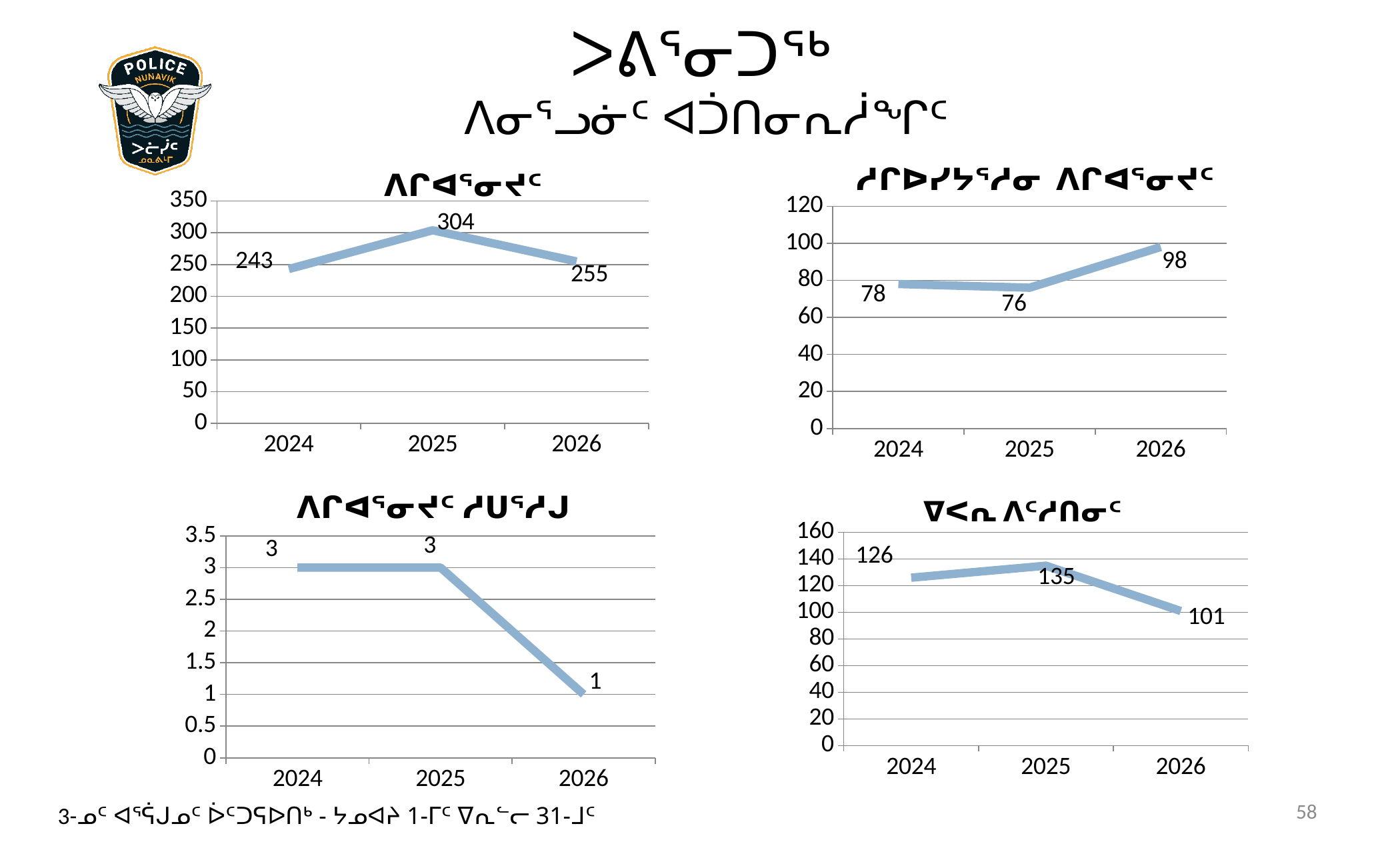
In the top-left chart, what is the difference between the 2025 and 2024 values? 61 What type of chart is the bottom-right chart? Line chart In the top-left chart, which year has the lowest value? 2024 In the top-right chart, is the value for 2024 larger or smaller than the value for 2025? larger In the top-left chart, what is the value for 2025? 304 In the bottom-left chart, what is the value for 2026? 1 In the bottom-right chart, what is the value for 2024? 126 In the top-right chart, what is the value for 2026? 98 In the bottom-left chart, how many data points are plotted? 3 In the bottom-right chart, what is the difference between the 2025 and 2026 values? 34 In the top-right chart, which year has the highest value? 2026 In the bottom-right chart, does the value rise or fall from 2025 to 2026? Fall